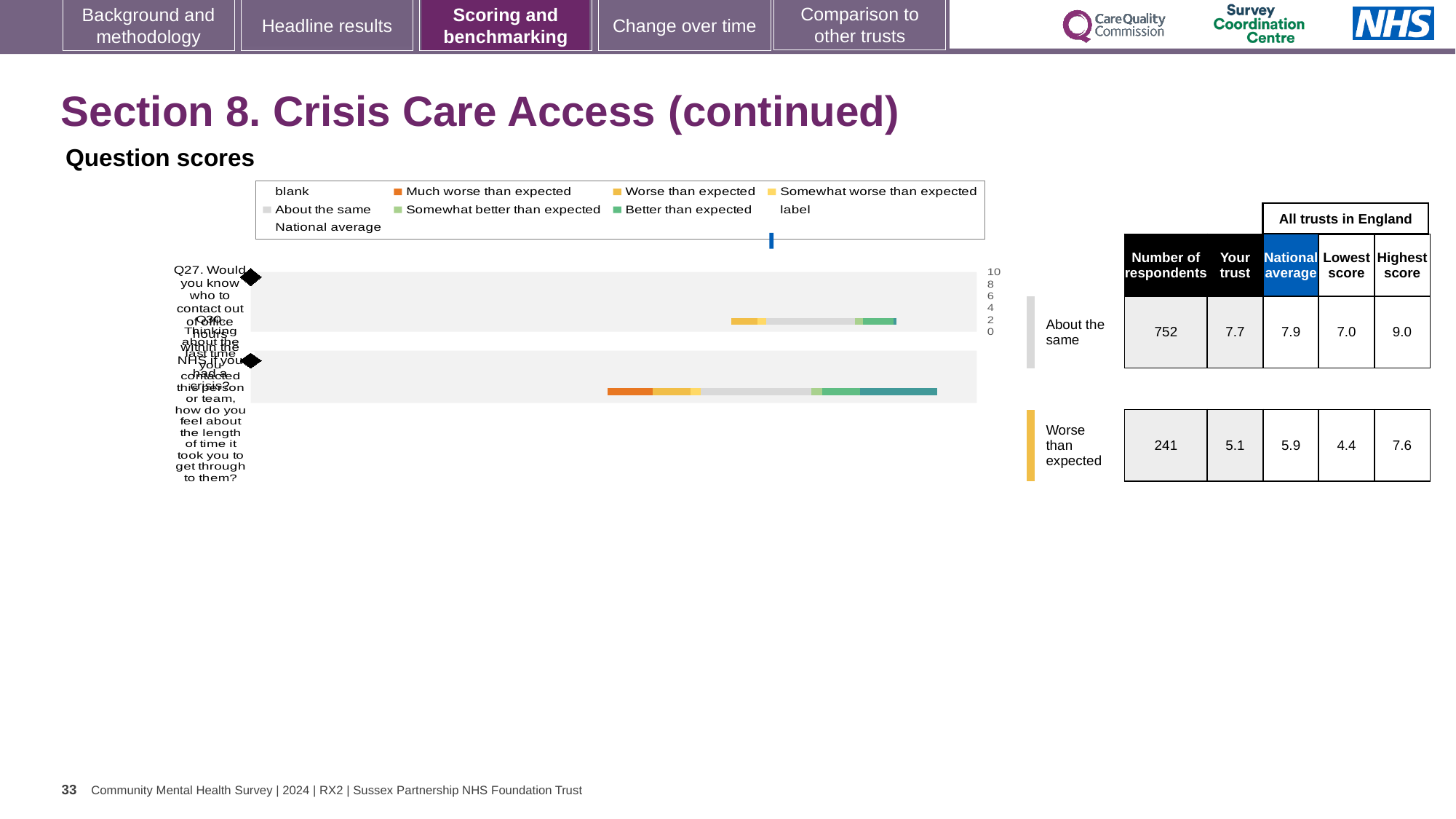
What is the difference between the highest and lowest scores for Q27? 2.0 What is the 'Your trust' score for Q27? 7.7 By how much is the national average for Q30 higher than the 'Your trust' score for Q30? 0.8 Which question has the higher 'Your trust' score, Q27 or Q30? Q27 What is the lowest score among all trusts in England for Q30? 4.4 What kind of chart is used to show the question scores? bar chart How many questions (bars) are plotted in the question scores chart? 2 In the question scores chart legend, which category is shown in orange? Much worse than expected How many respondents answered Q27? 752 What is the national average score for Q30? 5.9 Which benchmark category is Q27 (would you know who to contact out of office hours) placed in? About the same Which benchmark category is Q30 (length of time it took to get through) placed in? Worse than expected